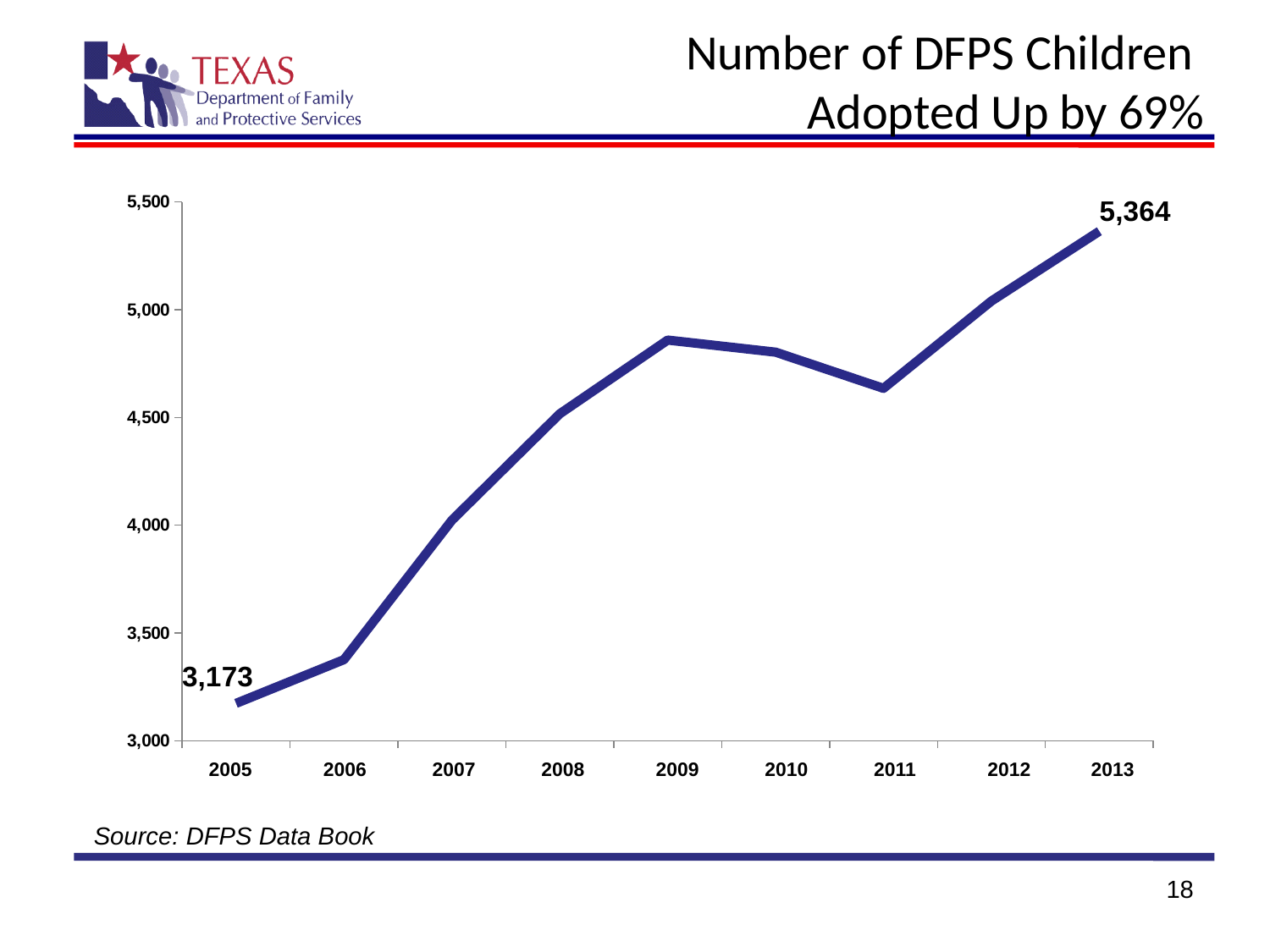
Which year has the highest number of DFPS children adopted? 2013 Which year has the lowest number of DFPS children adopted? 2005 What kind of chart is shown on the slide? line chart What is the number of DFPS children adopted in 2013? 5,364 What is the number of DFPS children adopted in 2005? 3,173 What is the source cited for the chart? DFPS Data Book Is the value for 2011 greater or less than 5,000? less Which year has the larger value, 2009 or 2011? 2009 What is the difference between the number of children adopted in 2013 and in 2005? 2,191 How many years are shown on the x axis? 9 Is the value for 2006 greater or less than 3,500? less